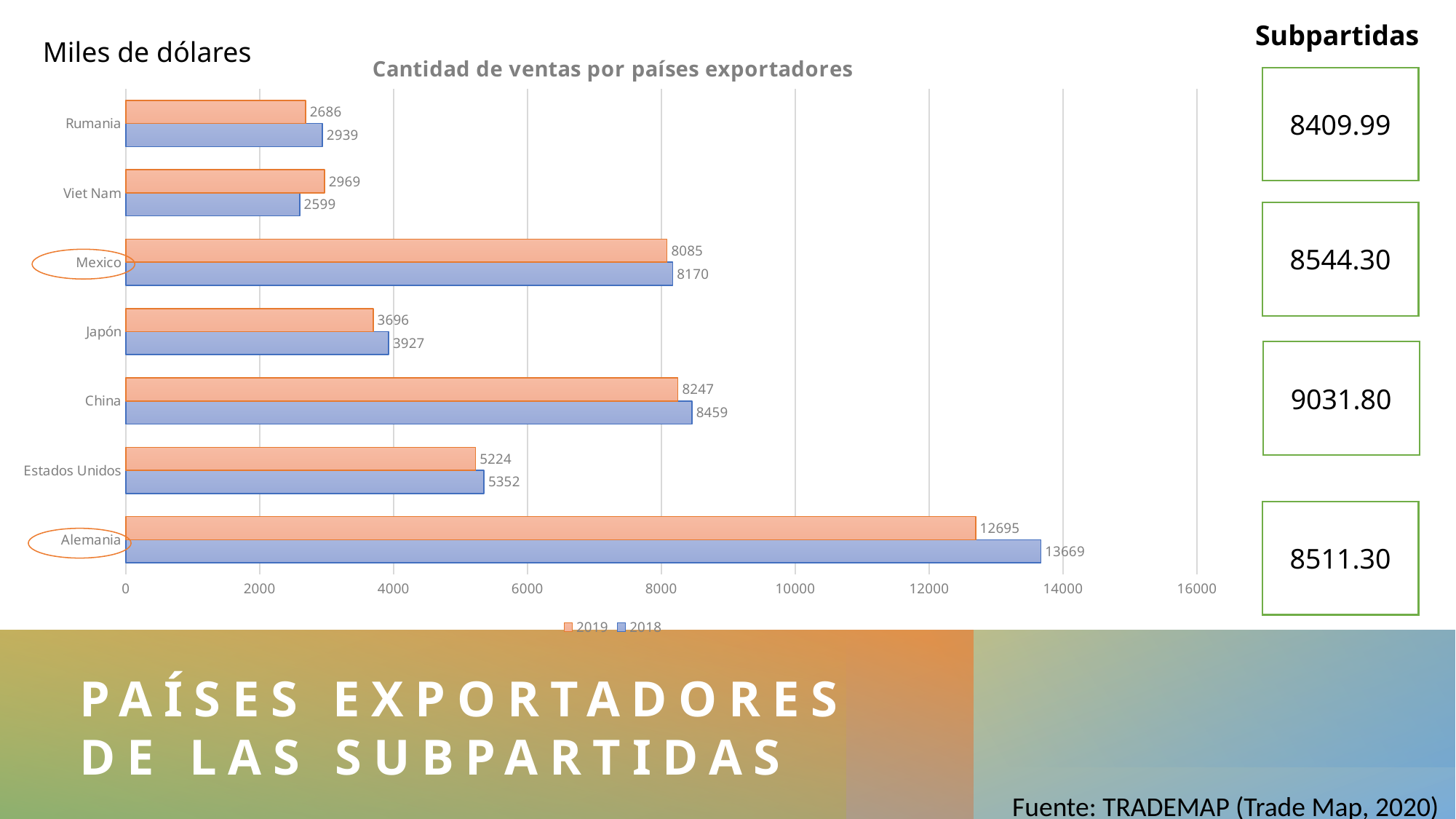
What is the 2019 value for Viet Nam? 2969 What is the 2019 value for Alemania? 12695 What kind of chart is shown? bar chart What is the title of the chart? Cantidad de ventas por países exportadores What is the 2018 value for China? 8459 How many series does the legend list? 2 Which country has the highest 2018 value? Alemania What is the difference between the 2018 and 2019 values for Alemania? 974 Which country has the lowest 2019 value? Rumania Which is larger for Mexico, the 2019 value or the 2018 value? 2018 Is the 2018 value for Estados Unidos greater or less than 6000? less How many countries are shown on the chart? 7